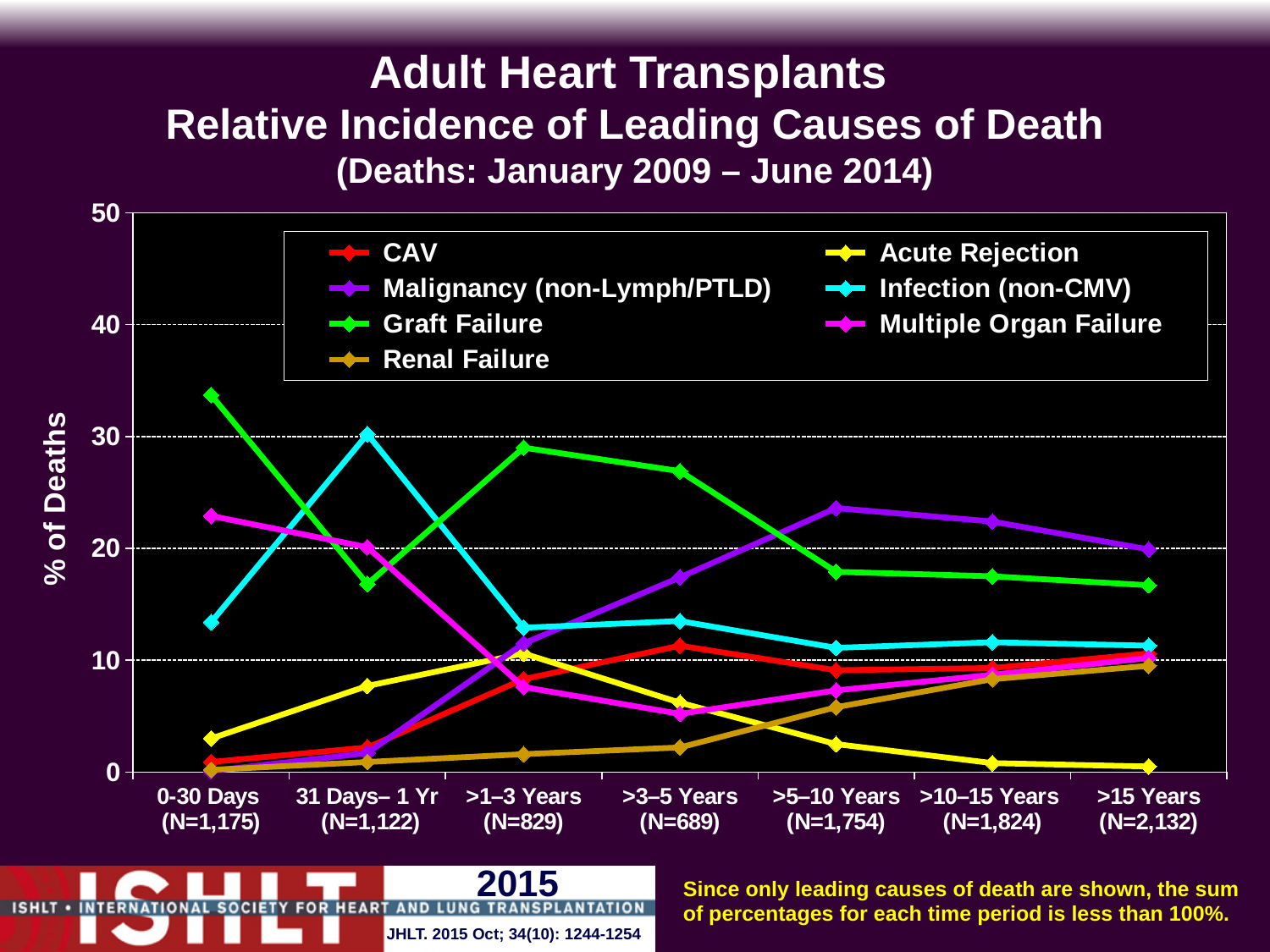
What is the label on the y axis? % of Deaths Which cause of death has the highest percentage in the >5–10 Years period? Malignancy (non-Lymph/PTLD) Which cause of death has the highest percentage in the 0-30 Days period? Graft Failure Is the value for Graft Failure in the 0-30 Days period greater or less than 30? greater What kind of chart is shown on the slide? Line chart How many causes of death does the legend list? 7 How many time periods are shown along the x axis? 7 Which cause of death has the lowest percentage in the >15 Years period? Acute Rejection In the >15 Years period, which is larger: Malignancy (non-Lymph/PTLD) or Graft Failure? Malignancy (non-Lymph/PTLD) Is the value for Malignancy (non-Lymph/PTLD) in the >5–10 Years period greater or less than 20? greater Which cause of death has the highest percentage in the 31 Days– 1 Yr period? Infection (non-CMV) Does the Malignancy (non-Lymph/PTLD) line rise or fall from 0-30 Days to >5–10 Years? Rise